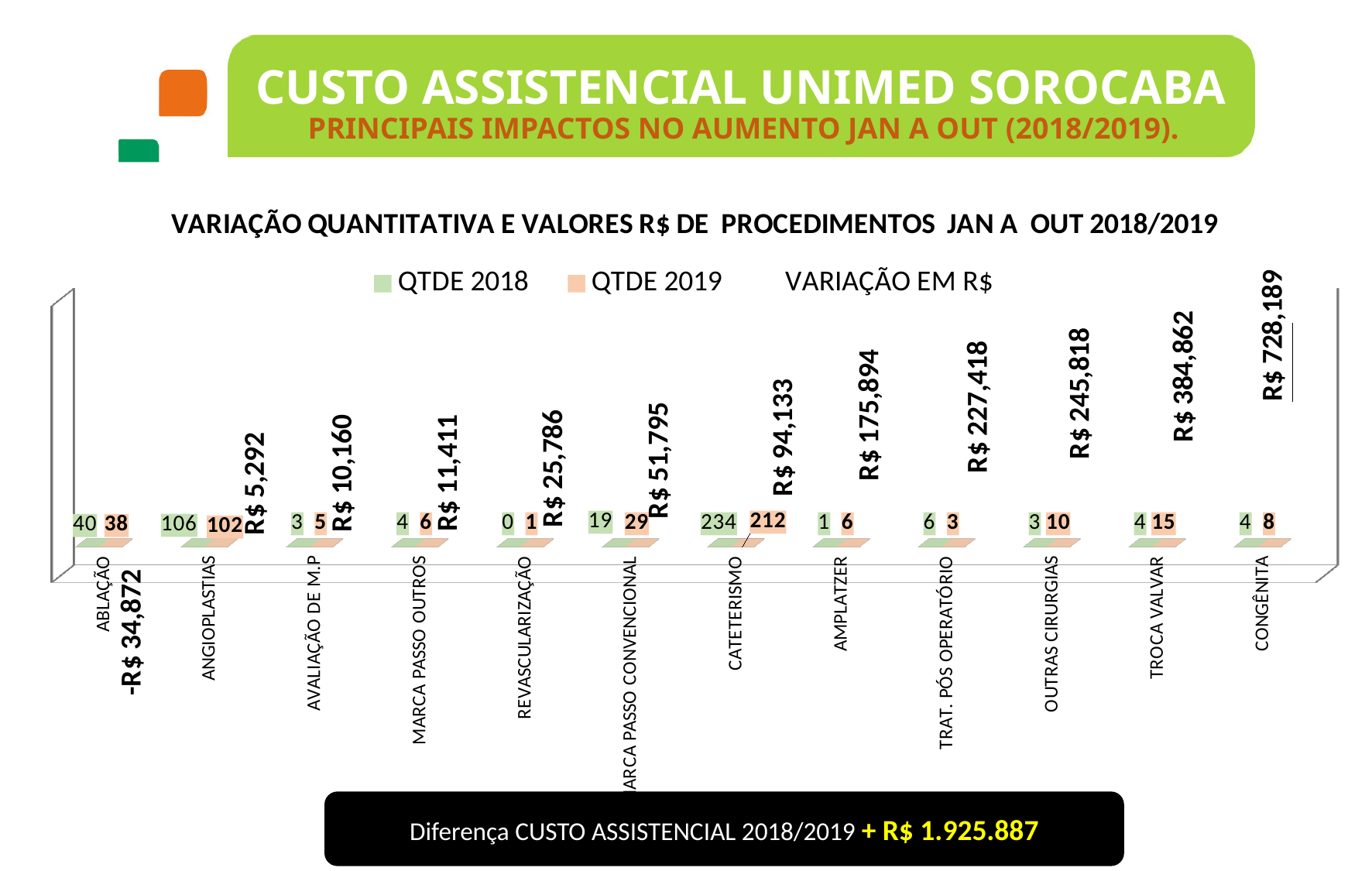
Which is larger for ANGIOPLASTIAS, the QTDE 2018 value or the QTDE 2019 value? QTDE 2018 What is the title of the chart? VARIAÇÃO QUANTITATIVA E VALORES R$ DE PROCEDIMENTOS JAN A OUT 2018/2019 How many series does the chart legend list? 3 Which category has the highest VARIAÇÃO EM R$? CONGÊNITA What is the difference between the QTDE 2019 and QTDE 2018 values for MARCA PASSO CONVENCIONAL? 10 Which category has the lowest VARIAÇÃO EM R$? ABLAÇÃO What kind of chart is shown on the slide? Bar chart What is the QTDE 2018 value for CATETERISMO? 234 What is the VARIAÇÃO EM R$ value for ABLAÇÃO? -R$ 34,872 How many categories are shown on the x axis of the chart? 12 What is the VARIAÇÃO EM R$ value for CONGÊNITA? R$ 728,189 What is the QTDE 2019 value for TROCA VALVAR? 15